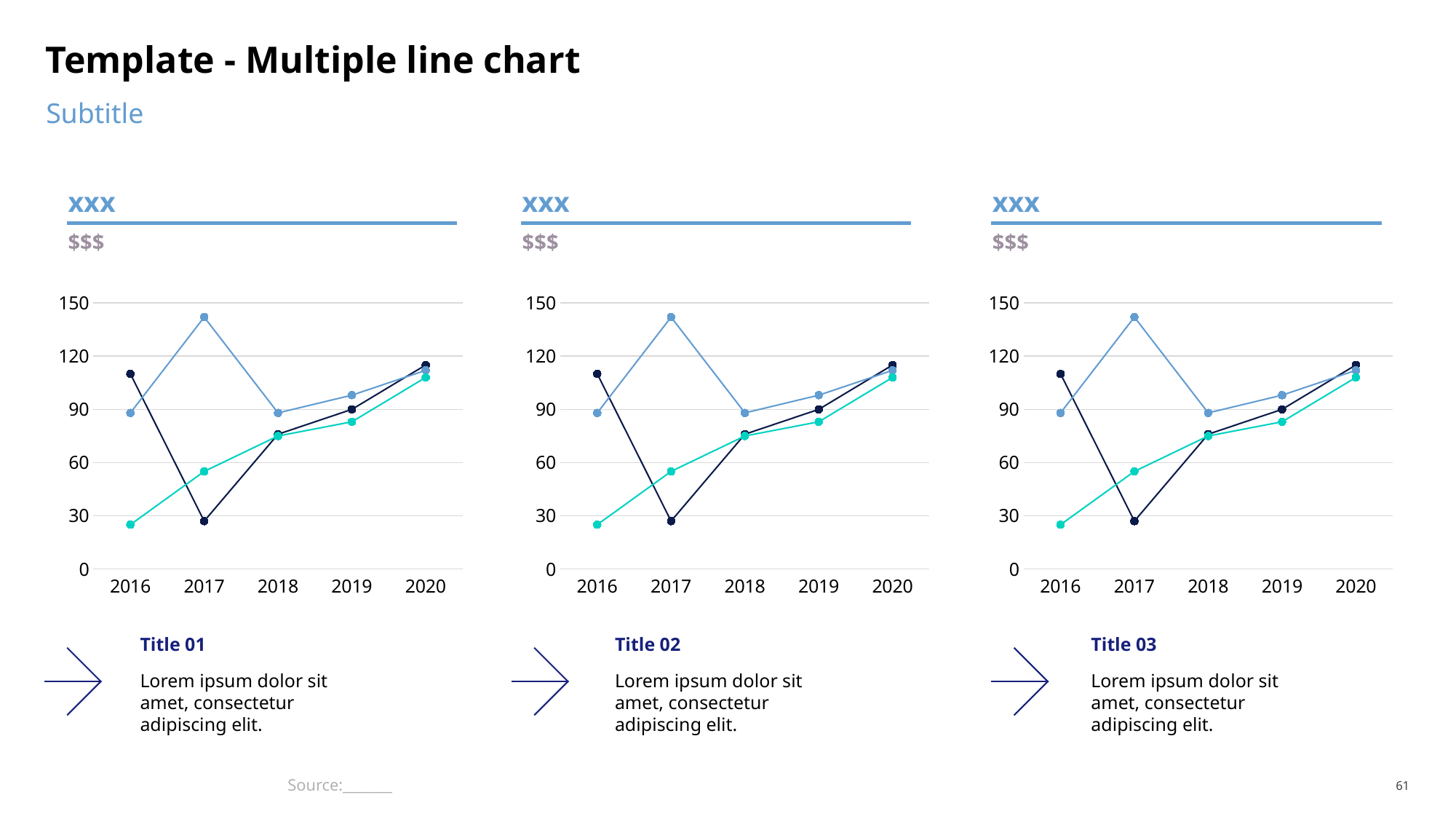
In the left chart, is the light blue line's value for 2017 greater or less than 120? greater In the left chart, which line has the higher value in 2016, the light blue line or the dark navy line? the dark navy line How many lines are plotted in the right chart? 3 In the middle chart, is the teal line's value for 2016 greater or less than 30? less In the middle chart, does the teal line rise or fall from 2016 to 2020? rise How many charts are shown on the slide? 3 In the left chart, is the dark navy line's value for 2020 greater or less than 90? greater In the left chart, in which year does the light blue line reach its highest value? 2017 How many years are shown on the x axis of the middle chart? 5 What type of chart is the left chart on the slide? line chart In the right chart, in which year is the dark navy line at its lowest value? 2017